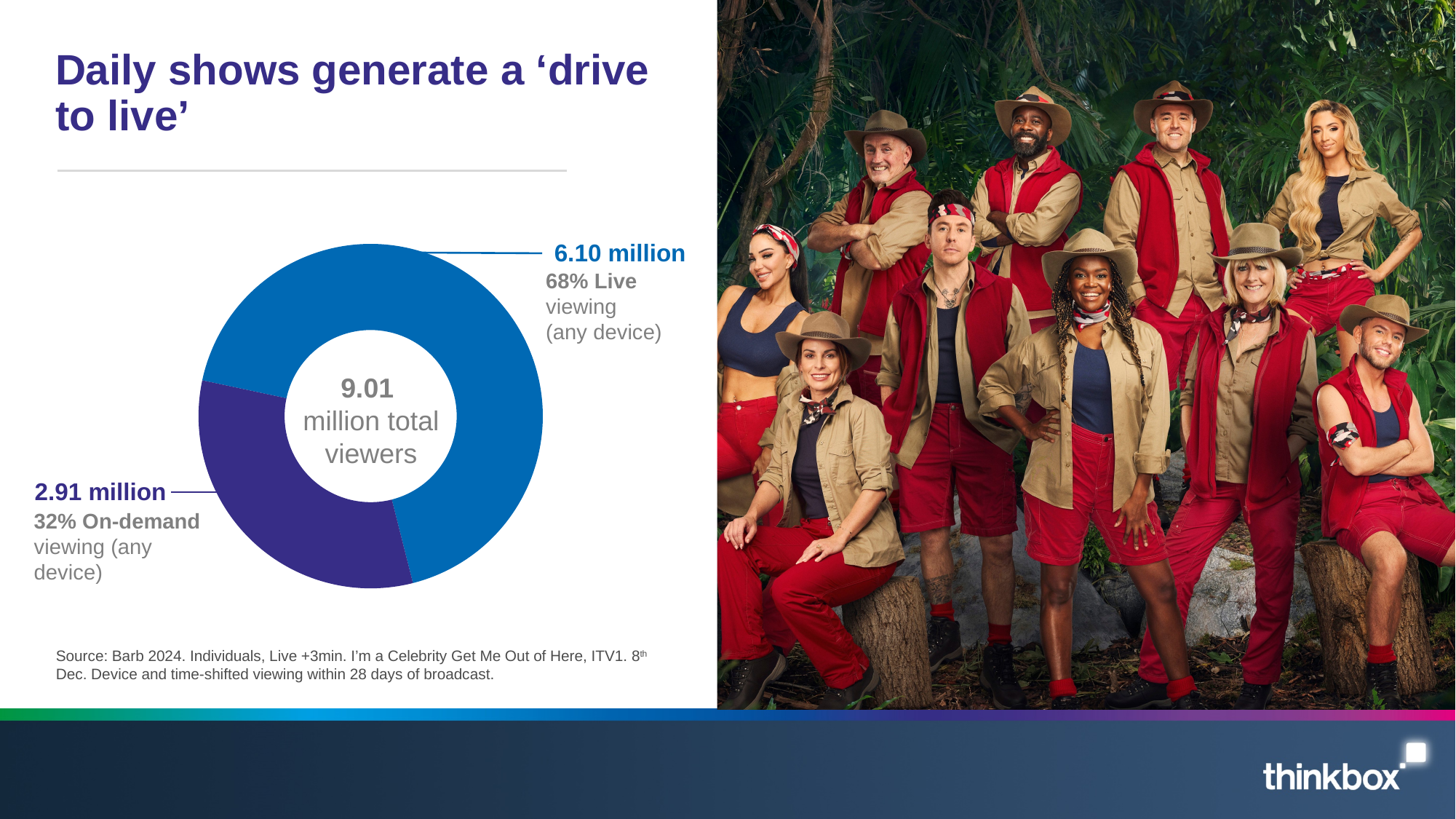
How many million viewers does the chart show for On-demand viewing (any device)? 2.91 million How many segments does the doughnut chart have? 2 How many million viewers does the chart show for Live viewing (any device)? 6.10 million What is the difference in million viewers between Live viewing and On-demand viewing? 3.19 million What share of total viewing is On-demand viewing? 32% What share of total viewing is Live viewing? 68% Which segment is larger, Live viewing or On-demand viewing? Live viewing What kind of chart is shown on the slide? Doughnut (pie) chart What colour is the On-demand viewing segment of the chart? Purple Which segment of the chart is the smallest? On-demand viewing (any device) What is the title of the slide containing the chart? Daily shows generate a ‘drive to live’ What is the total number of viewers shown in the centre of the chart? 9.01 million